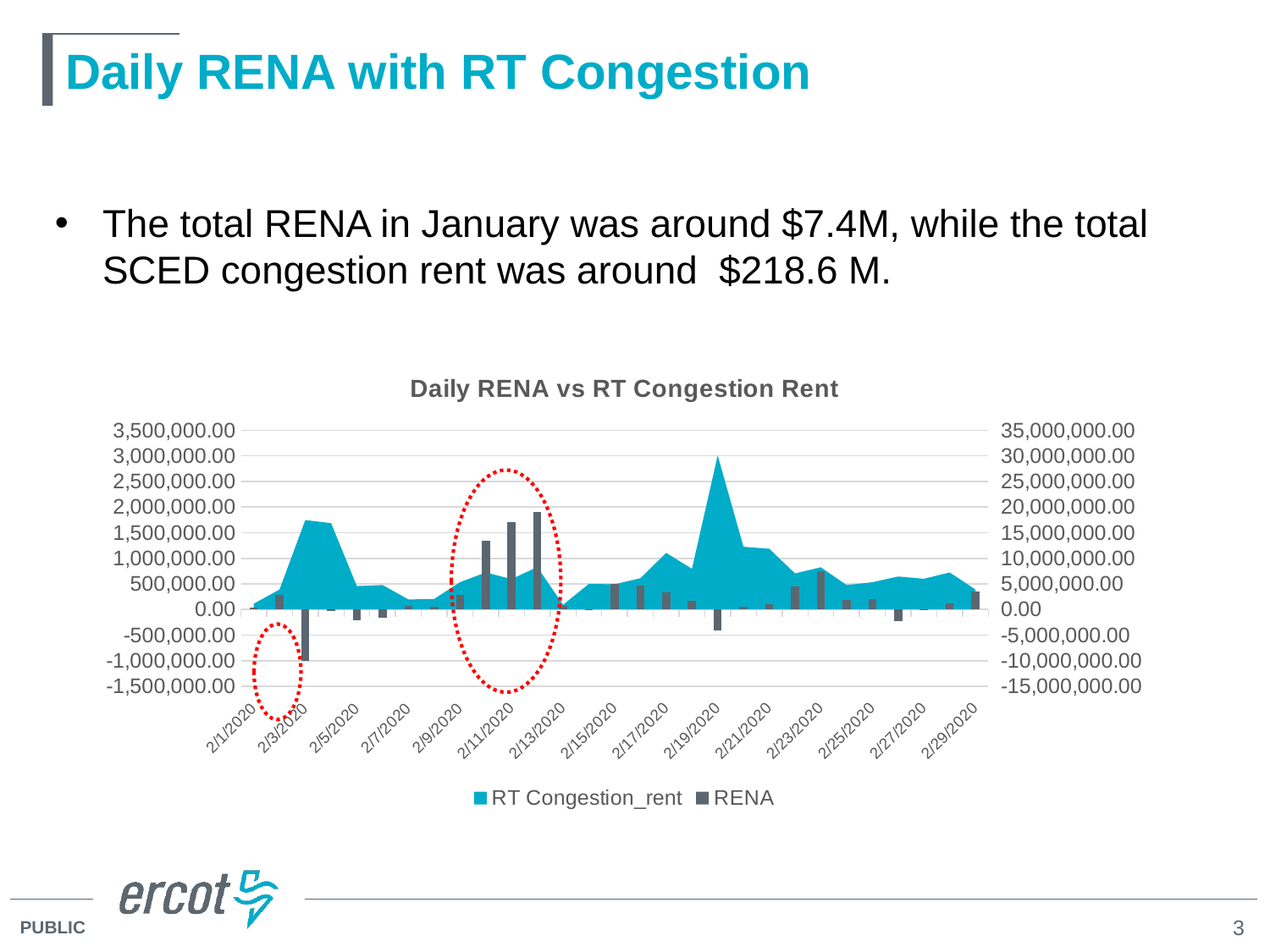
What are the two series named in the chart's legend? RT Congestion_rent and RENA How many series does the chart's legend list? 2 On which date does the RT Congestion_rent series reach its highest value? 2/19/2020 Is the peak RT Congestion_rent value on 2/19/2020 greater or less than 25,000,000.00 on the right axis? greater What is the title of the chart on the slide? Daily RENA vs RT Congestion Rent On which date is the RENA bar the lowest (most negative)? 2/3/2020 Does the RT Congestion_rent series rise or fall between 2/19/2020 and 2/21/2020? fall Is the tallest RENA bar (around 2/12/2020) greater or less than 1,500,000.00 on the left axis? greater Is the RENA value for 2/3/2020 greater or less than 0.00? less Which is larger, the RT Congestion_rent value on 2/19/2020 or on 2/5/2020? 2/19/2020 What kind of chart is shown on the slide? A combination chart with an area series and a bar series How many date labels are shown on the chart's x axis? 15